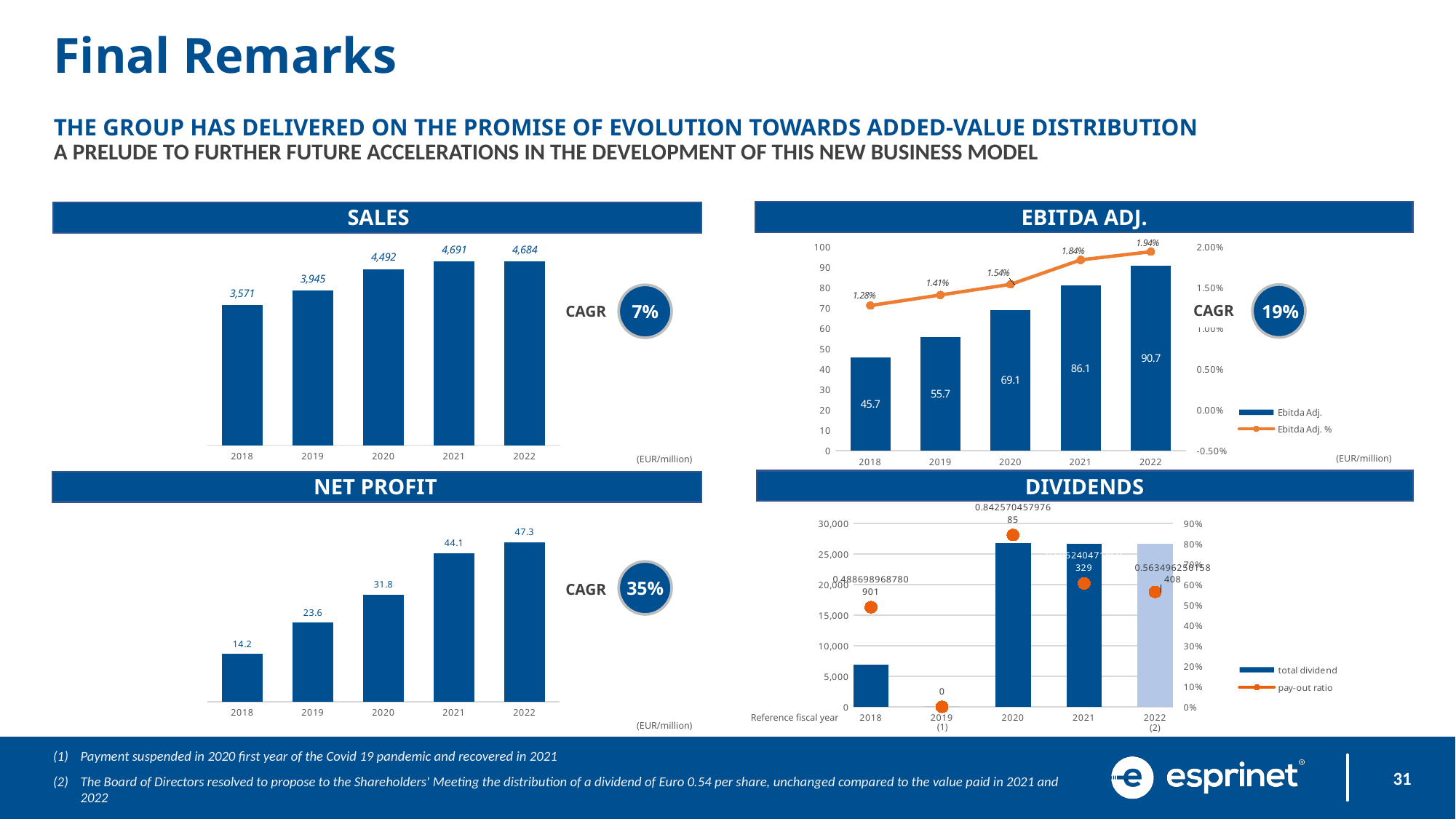
In the EBITDA ADJ. chart, do the Ebitda Adj. bar values rise or fall from 2018 to 2022? rise In the SALES chart, which year has the highest value? 2021 In the DIVIDENDS chart, is the total dividend for 2018 greater or less than 10,000? less In the NET PROFIT chart, which year has the lowest value? 2018 In the SALES chart, what is the difference between the 2019 and 2018 values? 374 In the EBITDA ADJ. chart, what is the Ebitda Adj. % value for 2019? 1.41% In the EBITDA ADJ. chart, how many series does the legend list? 2 In the NET PROFIT chart, what is the difference between the 2022 and 2021 values? 3.2 In the SALES chart, what is the value for 2020? 4,492 In the EBITDA ADJ. chart, what is the Ebitda Adj. value for 2021? 86.1 In the DIVIDENDS chart, what kind of chart is used for the total dividend series? bar chart In the NET PROFIT chart, what is the value for 2019? 23.6